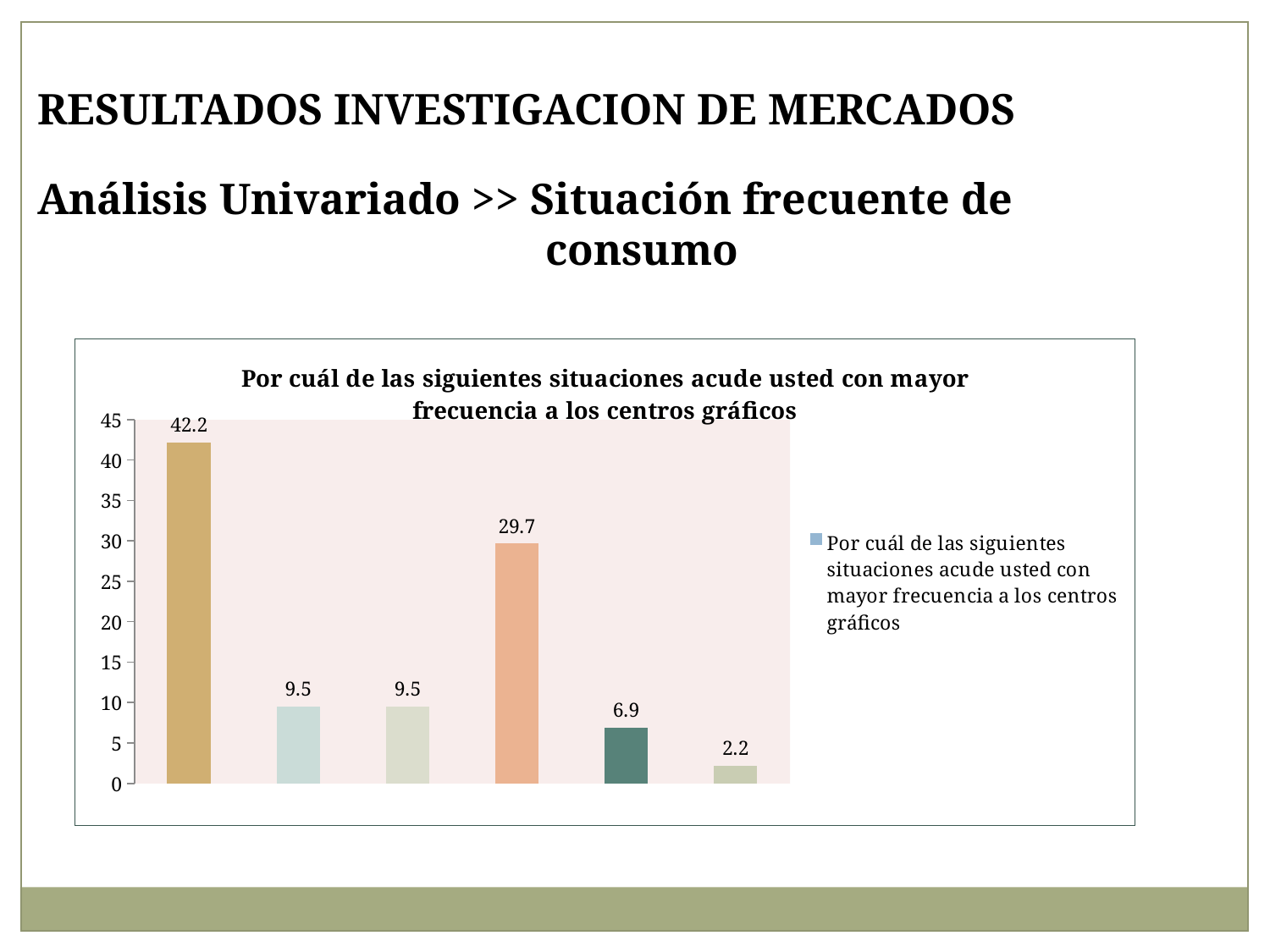
What is the value of the last (rightmost) bar in the chart? 2.2 What kind of chart is shown on the slide? bar chart What is the value of the first (leftmost) bar in the chart? 42.2 What is the lowest value shown in the chart? 2.2 What is the difference between the first bar (42.2) and the fourth bar (29.7)? 12.5 Which is larger, the value of the fourth bar or the value of the fifth bar? the fourth bar (29.7) What is the value of the fourth bar from the left (the orange bar)? 29.7 How many series does the legend list? 1 How many bars are plotted in the chart? 6 What is the title of the chart? Por cuál de las siguientes situaciones acude usted con mayor frecuencia a los centros gráficos What is the highest value shown in the chart? 42.2 What is the value of the fifth bar from the left (the dark green bar)? 6.9